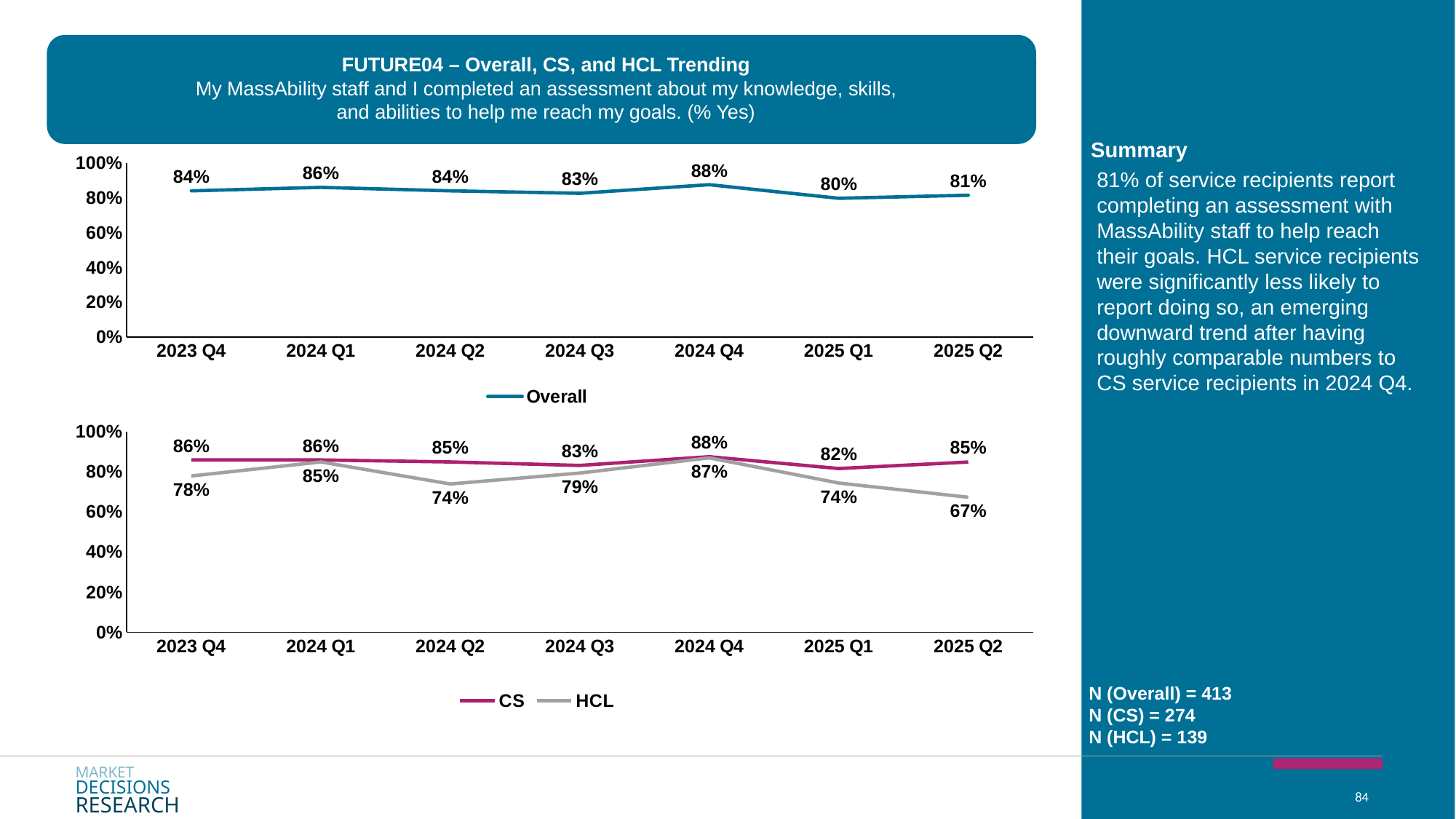
In the bottom chart, what is the HCL value for 2025 Q2? 67% What kind of chart is the top chart? Line chart In the top chart (Overall), what is the value for 2024 Q4? 88% In the bottom chart, which is larger in 2024 Q2: the CS value or the HCL value? CS In the top chart (Overall), what is the difference between the 2024 Q4 value and the 2025 Q1 value? 8 percentage points In the top chart (Overall), how many quarters are plotted on the x axis? 7 In the bottom chart, what is the difference between the CS and HCL values in 2025 Q2? 18 percentage points In the top chart (Overall), which quarter has the lowest value? 2025 Q1 In the bottom chart, which quarter has the lowest HCL value? 2025 Q2 In the bottom chart, what is the CS value for 2025 Q1? 82% How many series does the legend of the bottom chart list? 2 In the bottom chart, does the HCL value rise or fall from 2024 Q4 to 2025 Q2? Fall